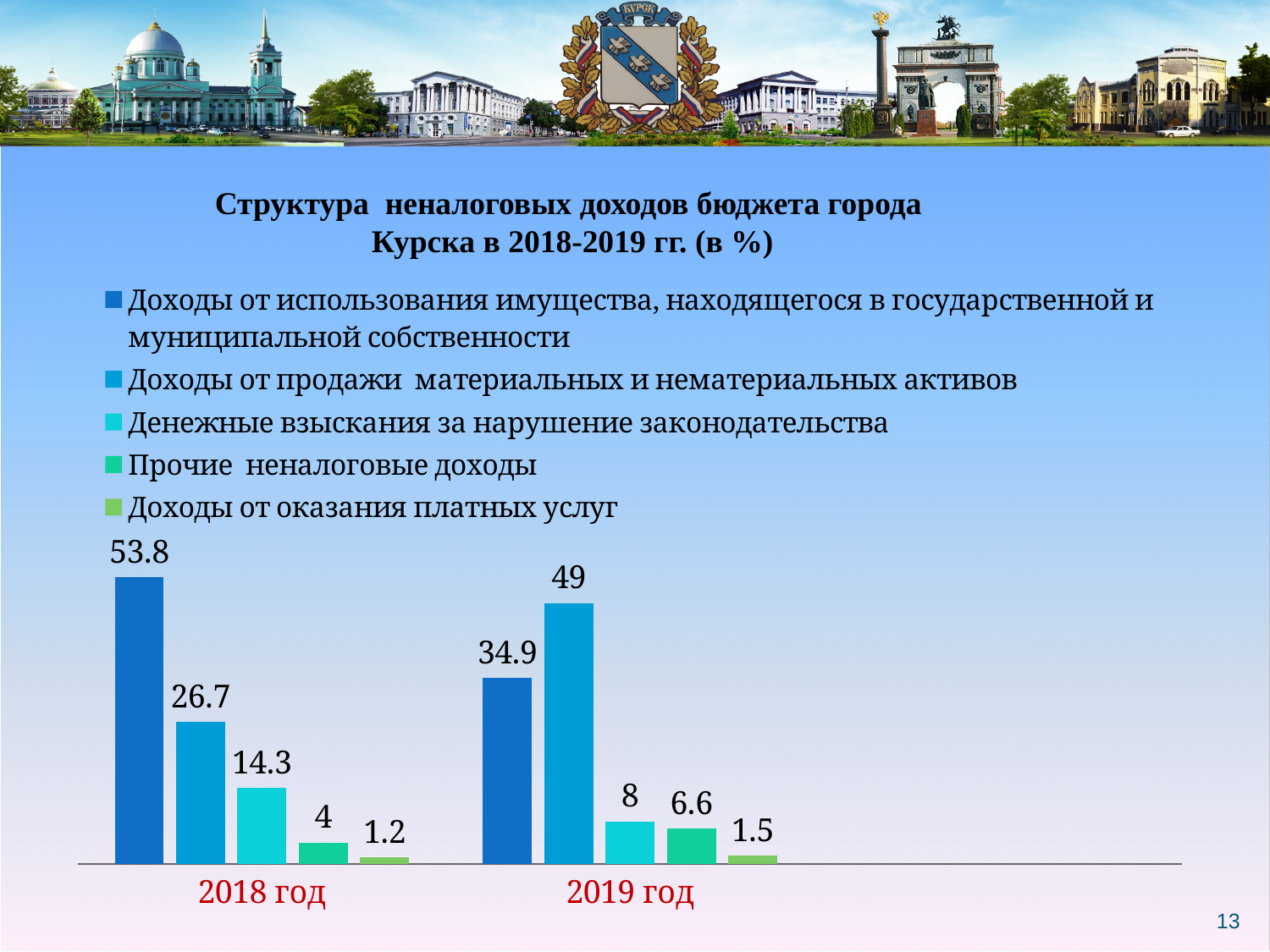
What is the title of the chart? Структура неналоговых доходов бюджета города Курска в 2018-2019 гг. (в %) Which series has the lowest value in 2018 год? Доходы от оказания платных услуг How many series does the legend list? 5 Which is larger: "Прочие неналоговые доходы" in 2018 год or in 2019 год? 2019 год What is the difference between the 2018 год and 2019 год values for "Доходы от использования имущества, находящегося в государственной и муниципальной собственности"? 18.9 Which series has the highest value in 2019 год? Доходы от продажи материальных и нематериальных активов What is the value for "Денежные взыскания за нарушение законодательства" in 2019 год? 8 What is the value for "Доходы от продажи материальных и нематериальных активов" in 2019 год? 49 What is the value for "Доходы от использования имущества, находящегося в государственной и муниципальной собственности" in 2018 год? 53.8 What kind of chart is shown on the slide? Bar chart How many year categories are shown on the x axis? 2 What is the value for "Доходы от оказания платных услуг" in 2018 год? 1.2